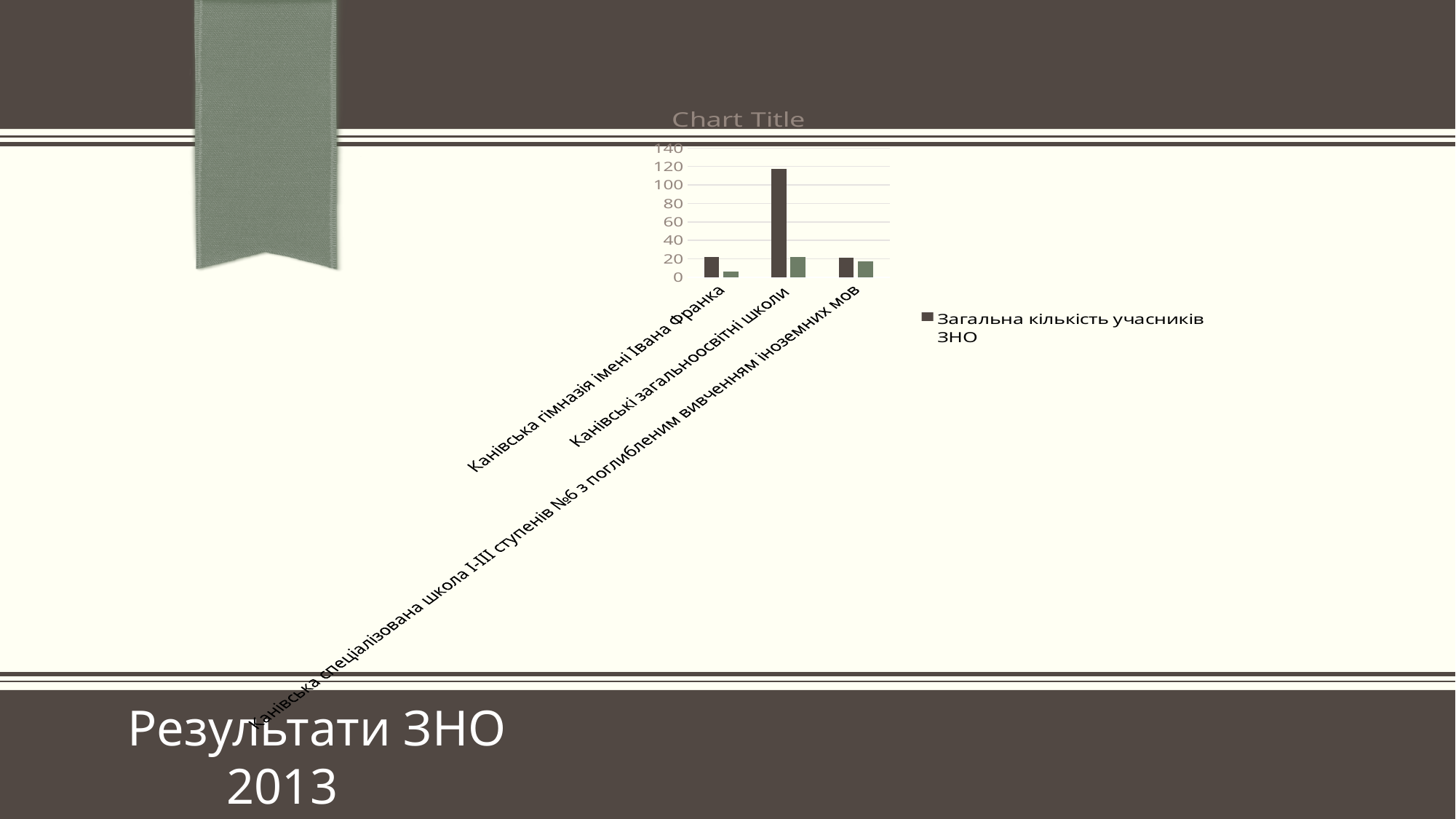
What series name is shown in the chart legend? Загальна кількість учасників ЗНО Is the value for 'Загальна кількість учасників ЗНО' for 'Канівська спеціалізована школа I-III ступенів №6 з поглибленим вивченням іноземних мов' greater or less than 60? less Is the green bar for 'Канівська гімназія імені Івана Франка' greater or less than 20? less Is the value for 'Загальна кількість учасників ЗНО' for 'Канівські загальноосвітні школи' greater or less than 100? greater How many categories are shown on the x axis of the chart? 3 Which category has the lowest green bar in the chart? Канівська гімназія імені Івана Франка Which has the larger value for 'Загальна кількість учасників ЗНО': 'Канівські загальноосвітні школи' or 'Канівська гімназія імені Івана Франка'? Канівські загальноосвітні школи Which category has the highest value for the series 'Загальна кількість учасників ЗНО'? Канівські загальноосвітні школи What kind of chart is shown on the slide? bar chart What is the highest value shown on the chart's vertical axis? 140 What is the title shown above the chart? Chart Title